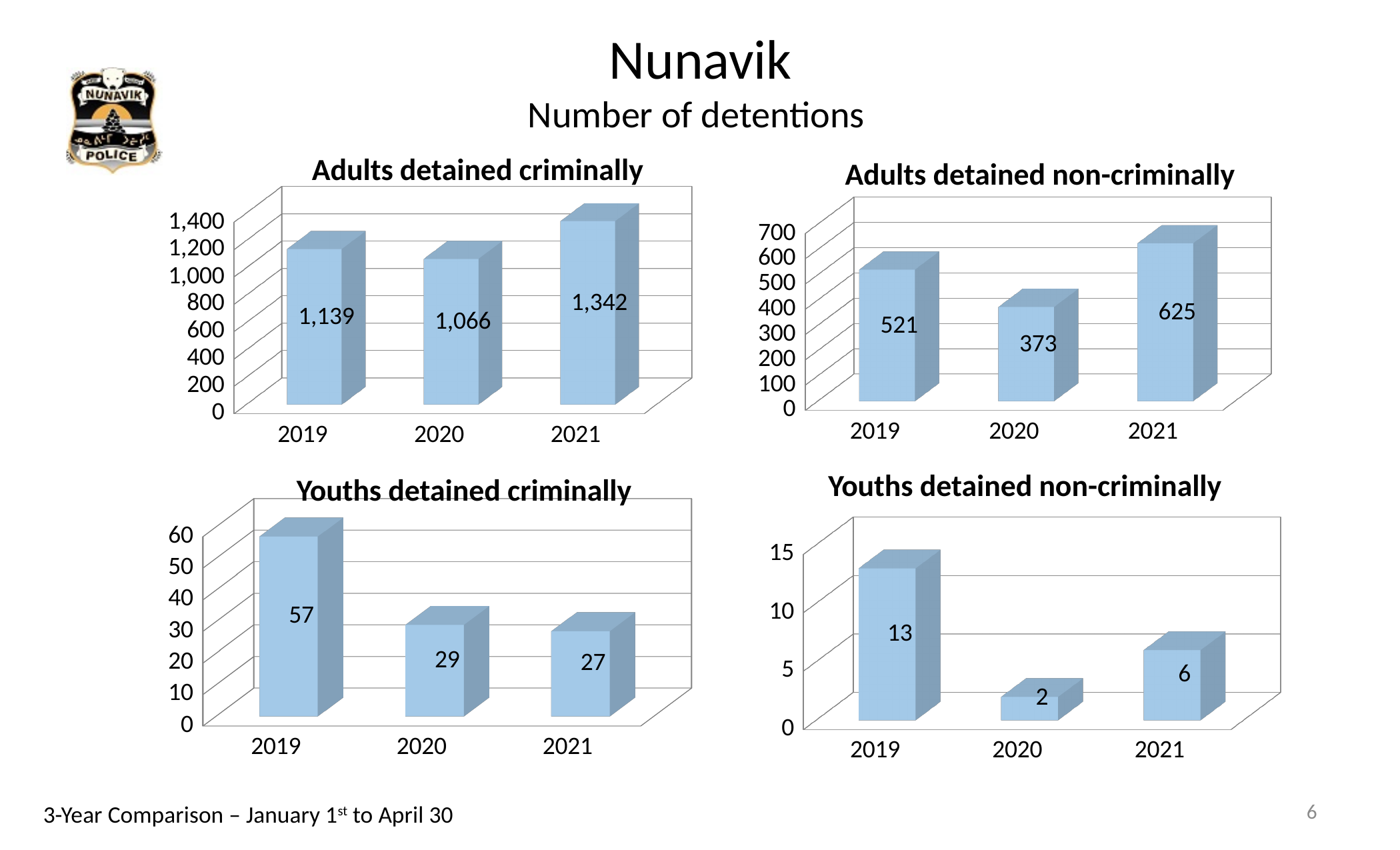
In the 'Youths detained non-criminally' chart, what is the value for 2019? 13 How many charts are shown on the slide? 4 In the 'Youths detained criminally' chart, how many years are shown on the x axis? 3 In the 'Adults detained non-criminally' chart, what is the value for 2020? 373 What kind of chart is the 'Youths detained non-criminally' chart? Bar chart In the 'Adults detained non-criminally' chart, what is the difference between the 2019 and 2020 values? 148 In the 'Youths detained non-criminally' chart, which year has the lowest value? 2020 In the 'Youths detained criminally' chart, do the values rise or fall from 2019 to 2021? Fall In the 'Adults detained criminally' chart, what is the value for 2021? 1,342 In the 'Adults detained criminally' chart, what is the difference between the 2021 and 2020 values? 276 In the 'Adults detained non-criminally' chart, which is larger, the value for 2019 or the value for 2021? 2021 In the 'Youths detained criminally' chart, which year has the highest value? 2019